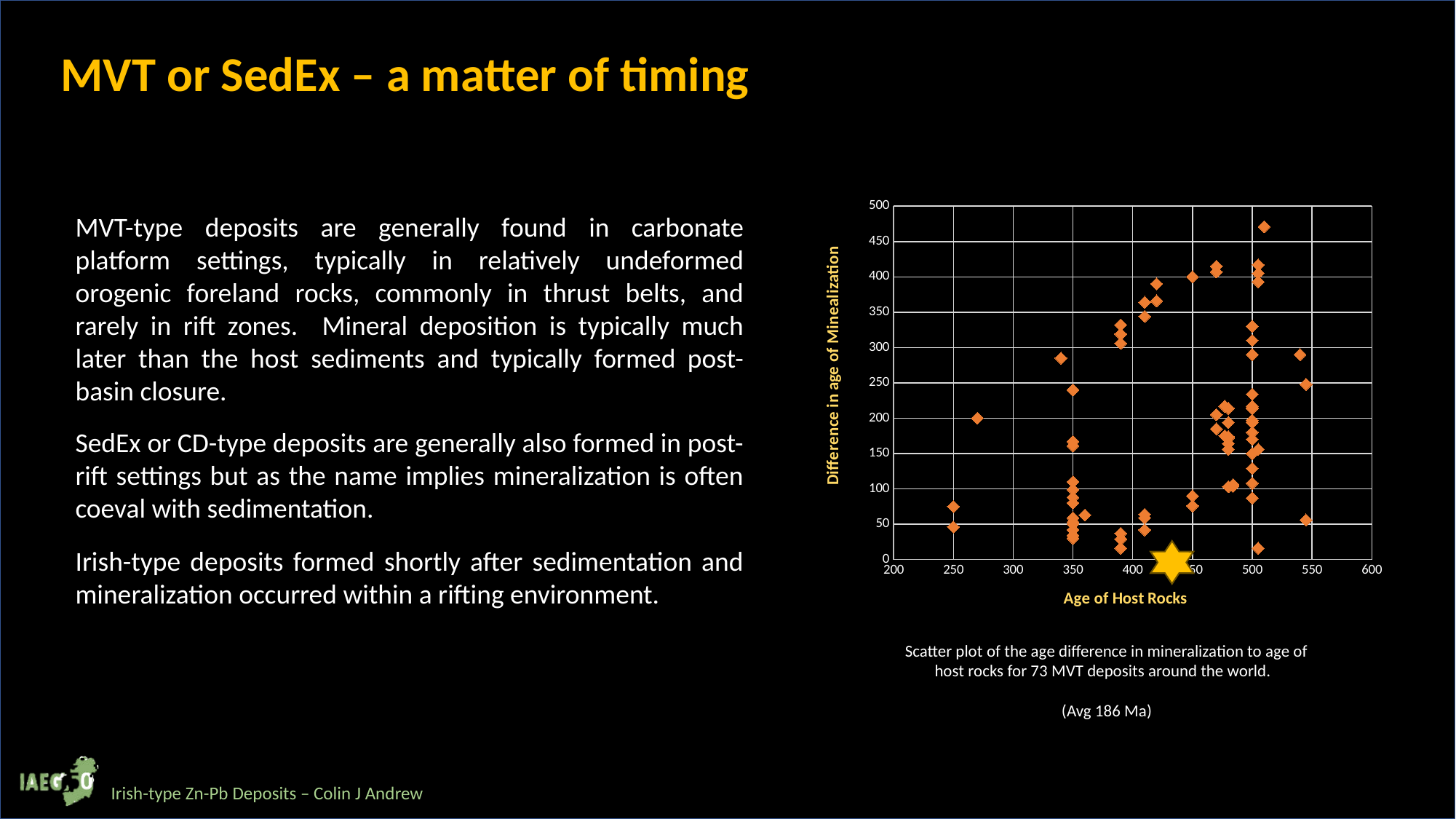
What is the label of the x axis of the scatter plot? Age of Host Rocks What kind of chart is shown on the slide? Scatter plot Is the difference in age of mineralization for the highest point in the scatter plot greater or less than 450? greater According to the caption, how many MVT deposits are plotted in the scatter plot? 73 What average value is stated below the scatter plot? Avg 186 Ma Is the age of host rocks for the leftmost point in the scatter plot greater or less than 300? less Is the difference in age of mineralization for the highest point in the scatter plot greater or less than 500? less